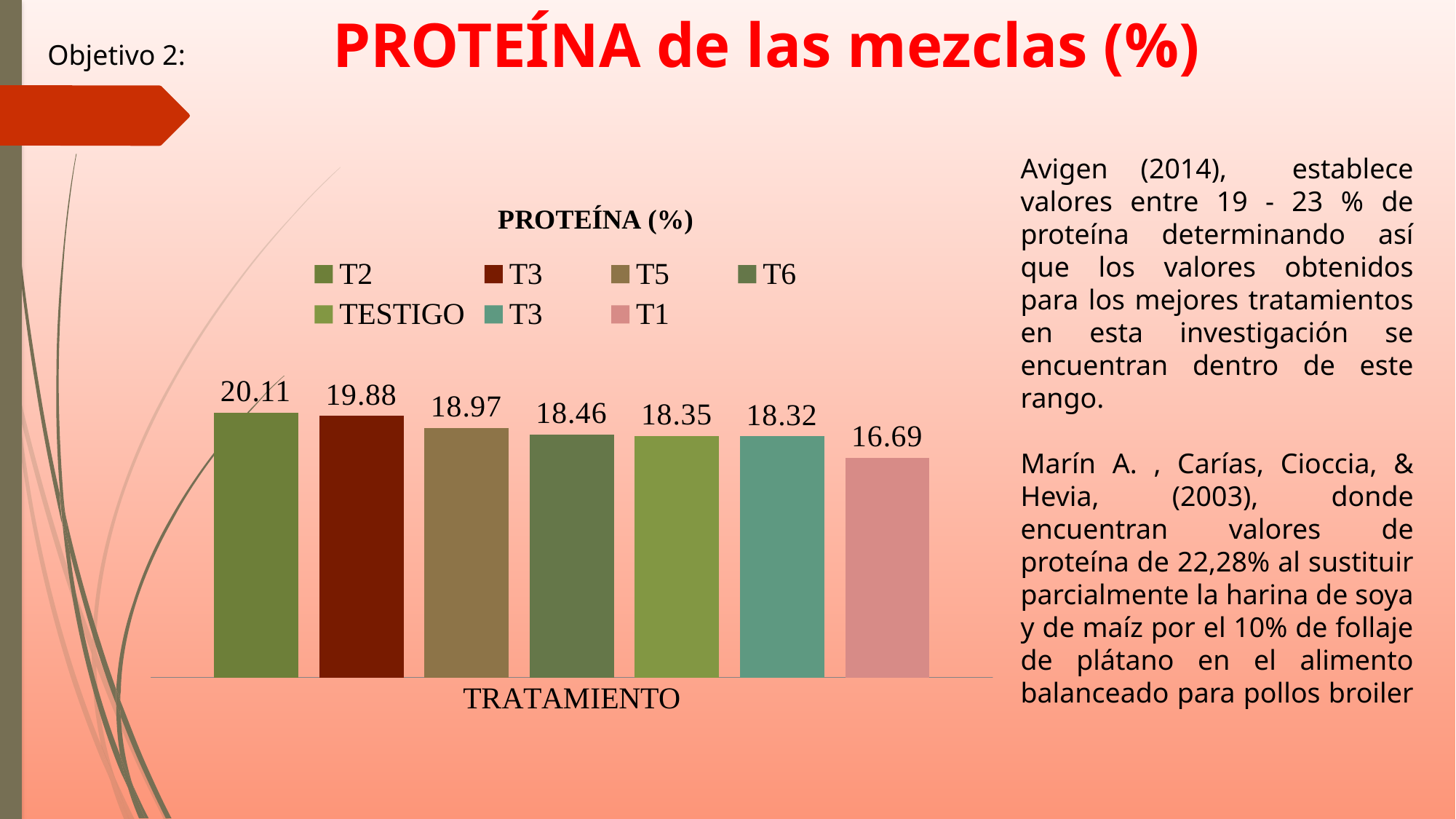
What is the title of the chart? PROTEÍNA (%) What is the protein value for T1? 16.69 What is the difference between the protein values of T2 and T1? 3.42 What is the protein value for T2? 20.11 Which treatment has the lowest protein value? T1 How many entries does the chart legend list? 7 What is the protein value for T5? 18.97 What is the protein value for TESTIGO? 18.35 Which treatment has the highest protein value? T2 What is the protein value for T6? 18.46 What type of chart is shown on the slide? bar chart How many bars are plotted in the chart? 7